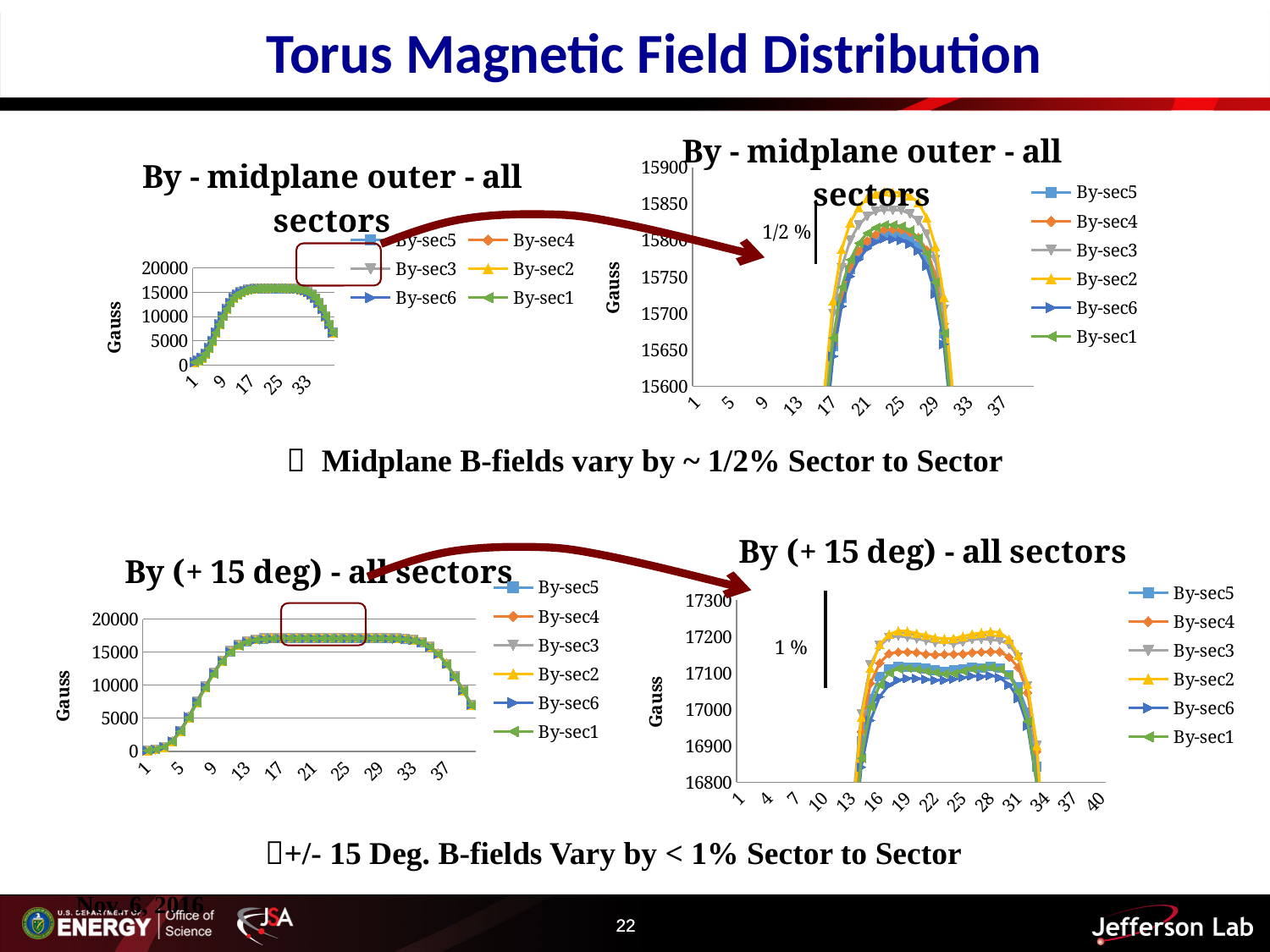
In the top-right 'By - midplane outer - all sectors' chart, is the peak value of By-sec2 greater or less than 15800? greater How many series does the legend list in the top-right 'By - midplane outer - all sectors' chart? 6 In the top-right 'By - midplane outer - all sectors' chart, which series reaches the highest peak? By-sec2 What is the first series listed in the legend of the top-left 'By - midplane outer - all sectors' chart? By-sec5 In the bottom-right 'By (+ 15 deg) - all sectors' chart, which series has the highest values across the plateau? By-sec2 In the bottom-left 'By (+ 15 deg) - all sectors' chart, do the values rise or fall along the x axis from 1 to 13? rise In the bottom-right 'By (+ 15 deg) - all sectors' chart, is the peak value of By-sec4 greater or less than 17100? greater In the bottom-right 'By (+ 15 deg) - all sectors' chart, which series has higher values on the plateau, By-sec2 or By-sec6? By-sec2 What is the y-axis label on the bottom-left 'By (+ 15 deg) - all sectors' chart? Gauss How many series does the legend list in the bottom-right 'By (+ 15 deg) - all sectors' chart? 6 What type of chart is the top-left chart titled 'By - midplane outer - all sectors'? line chart In the bottom-right 'By (+ 15 deg) - all sectors' chart, is the peak value of By-sec4 greater or less than 17200? less